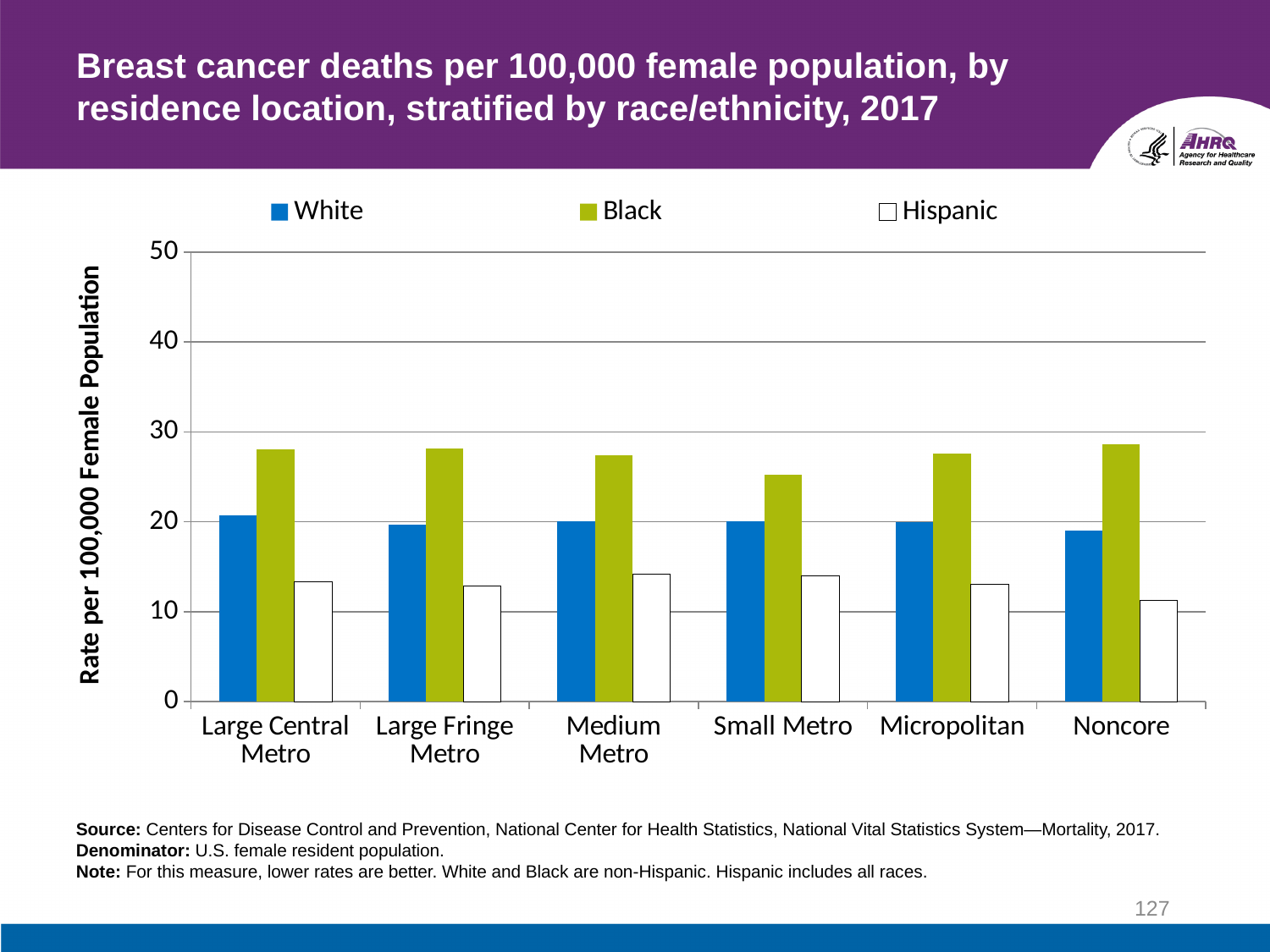
Which residence location has the lowest rate for the Hispanic series? Noncore Which residence location has the lowest rate for the Black series? Small Metro What kind of chart is shown on the slide? bar chart What is the label of the y axis? Rate per 100,000 Female Population Which residence location has the lowest rate for the White series? Noncore Is the value for Black in Small Metro greater or less than 20? greater In Noncore, which is larger, the Black rate or the White rate? Black How many residence location categories are shown on the x axis? 6 In Large Central Metro, which is larger, the White rate or the Hispanic rate? White Is the value for Hispanic in Noncore greater or less than 10? greater How many series does the legend list? 3 Is the value for Black in Large Central Metro greater or less than 30? less